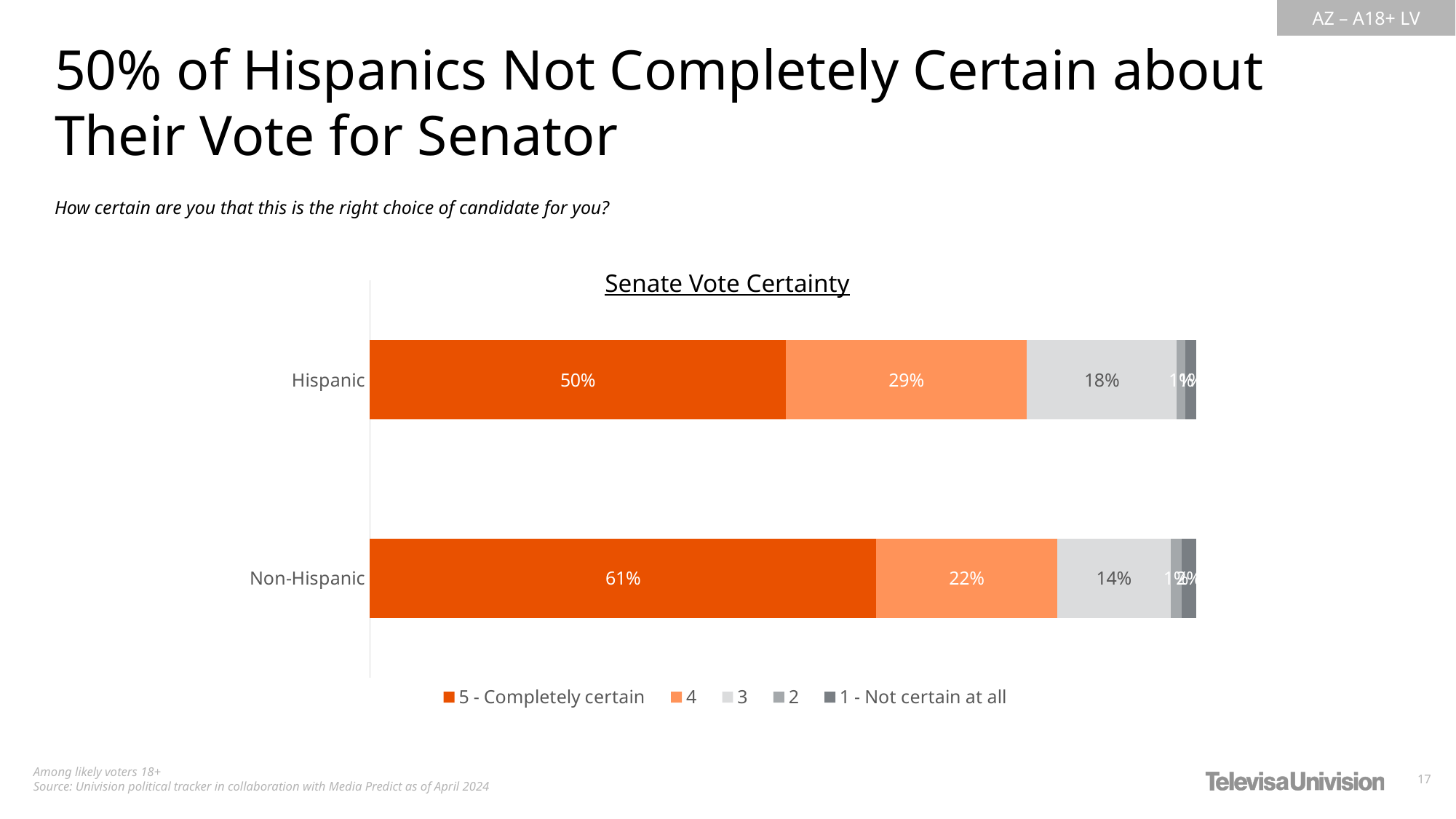
Which group has the higher share of "5 - Completely certain" voters? Non-Hispanic What is the title of the chart? Senate Vote Certainty What is the difference in percentage points between Non-Hispanic and Hispanic voters who are "5 - Completely certain"? 11 percentage points What is the value of the "4" segment for Non-Hispanic voters? 22% What type of chart is shown on the slide? Stacked bar chart Which group has the larger "3" segment, Hispanic or Non-Hispanic? Hispanic What percentage of Non-Hispanic likely voters are "5 - Completely certain" about their Senate vote? 61% What percentage of Hispanic likely voters are "5 - Completely certain" about their Senate vote? 50% How many series does the legend list? 5 How many groups (bars) are shown in the chart? 2 What is the value of the "4" segment for Hispanic voters? 29% What is the value of the "3" segment for Non-Hispanic voters? 14%